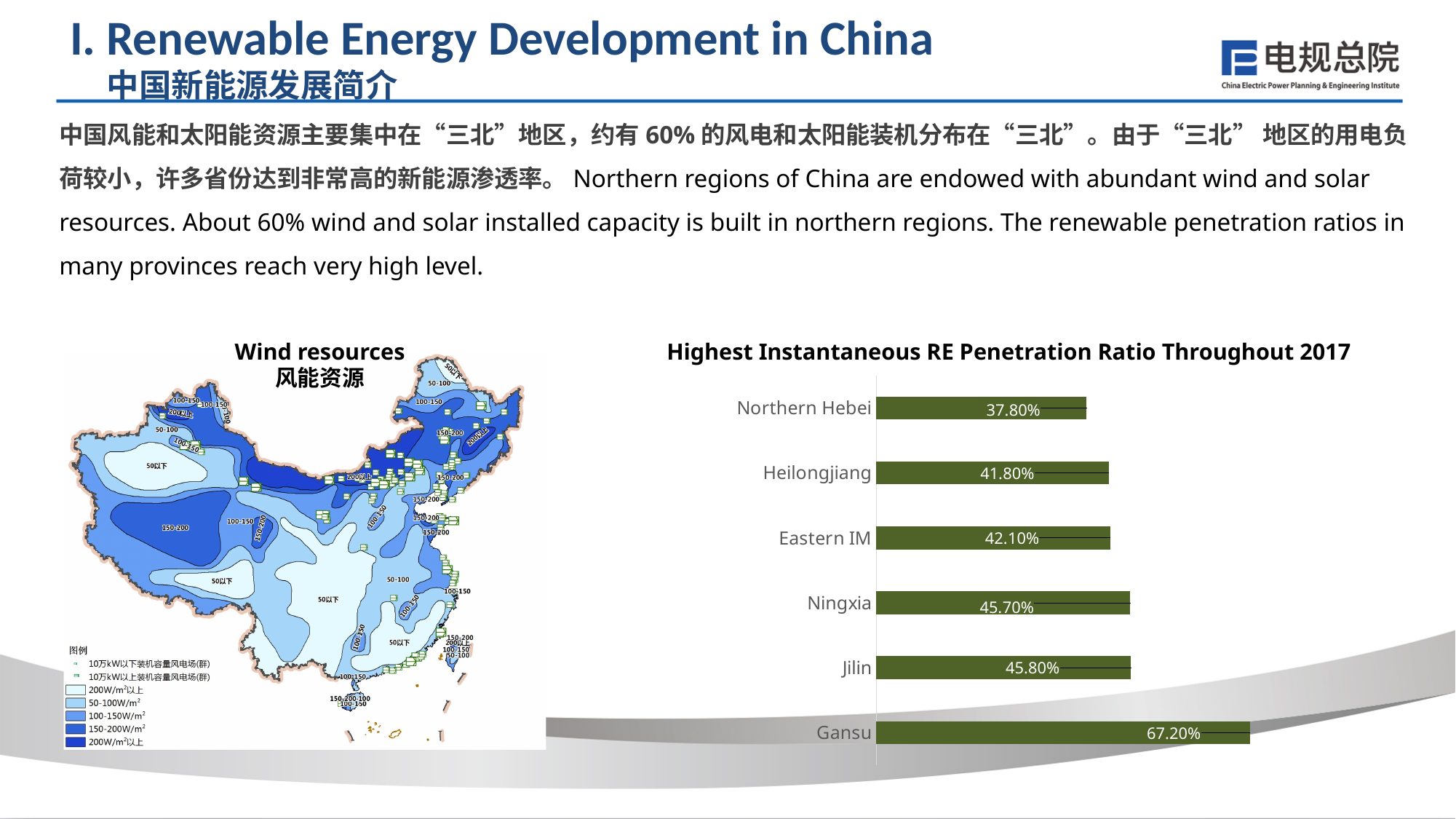
What type of chart is used to show the highest instantaneous RE penetration ratios? Bar chart How many regions are shown in the penetration ratio chart? 6 Which has a higher penetration ratio, Ningxia or Northern Hebei? Ningxia What is the title of the chart on the right side of the slide? Highest Instantaneous RE Penetration Ratio Throughout 2017 What is the difference between the penetration ratios of Heilongjiang and Northern Hebei? 4.00% What is the highest instantaneous RE penetration ratio for Gansu? 67.20% Which region has the lowest instantaneous RE penetration ratio in the chart? Northern Hebei Which region has the highest instantaneous RE penetration ratio in the chart? Gansu What is the value shown for Heilongjiang? 41.80% What is the value shown for Northern Hebei in the penetration ratio chart? 37.80% What is the value shown for Eastern IM? 42.10% What is the difference between the penetration ratios of Gansu and Jilin? 21.40%